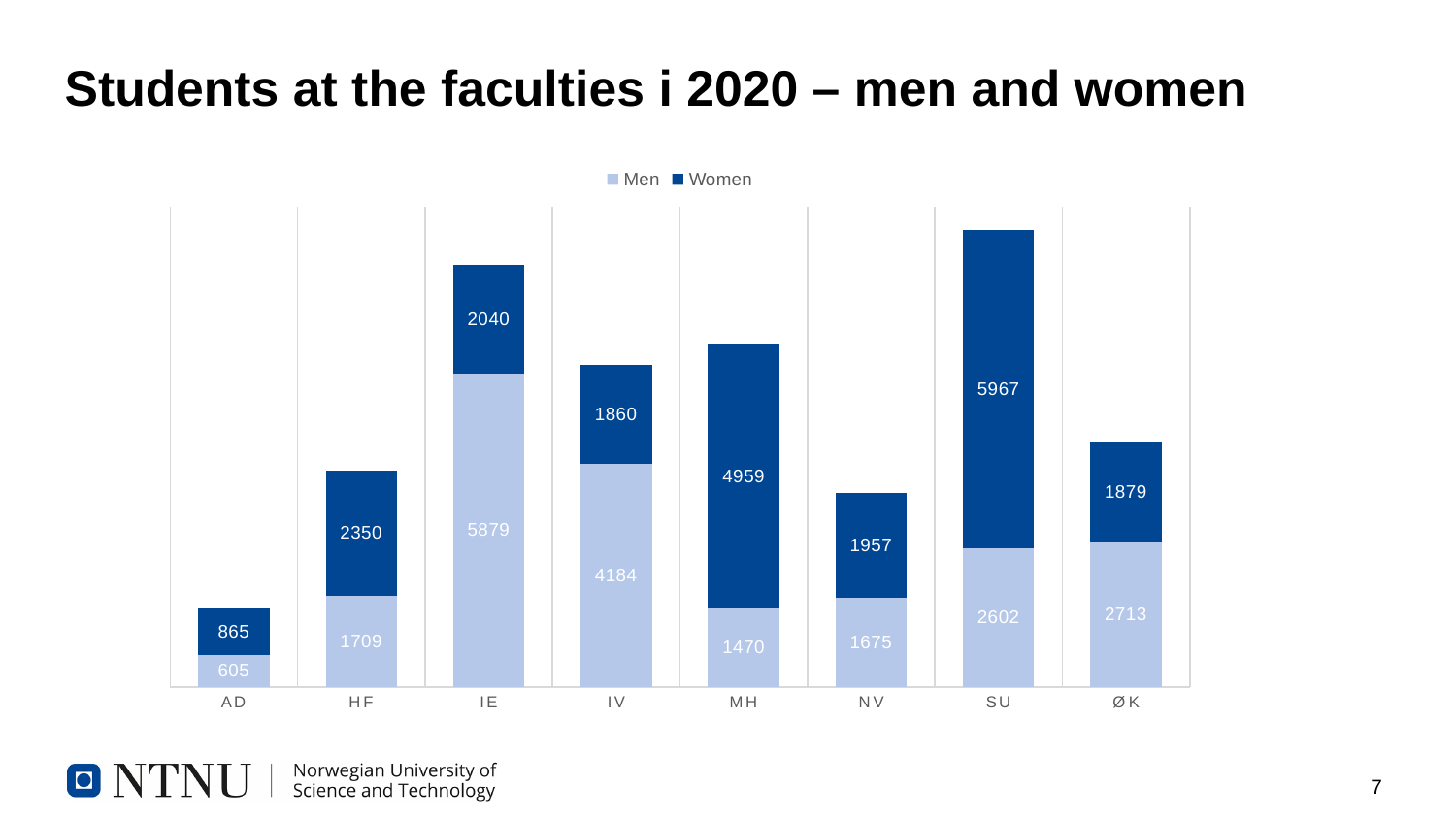
Which faculty has the lowest number of men students? AD How many men students are at the MH faculty? 1470 What kind of chart is shown on the slide? Stacked bar chart How many faculties are shown on the x axis? 8 How many series does the legend list? 2 How many women students are at the SU faculty? 5967 What is the total number of students at the HF faculty? 4059 What is the total number of students at the AD faculty? 1470 Which is larger at the ØK faculty, the number of men or the number of women? Men What is the difference between the number of women and men at the MH faculty? 3489 How many men students are at the IE faculty? 5879 Which faculty has the highest number of women students? SU